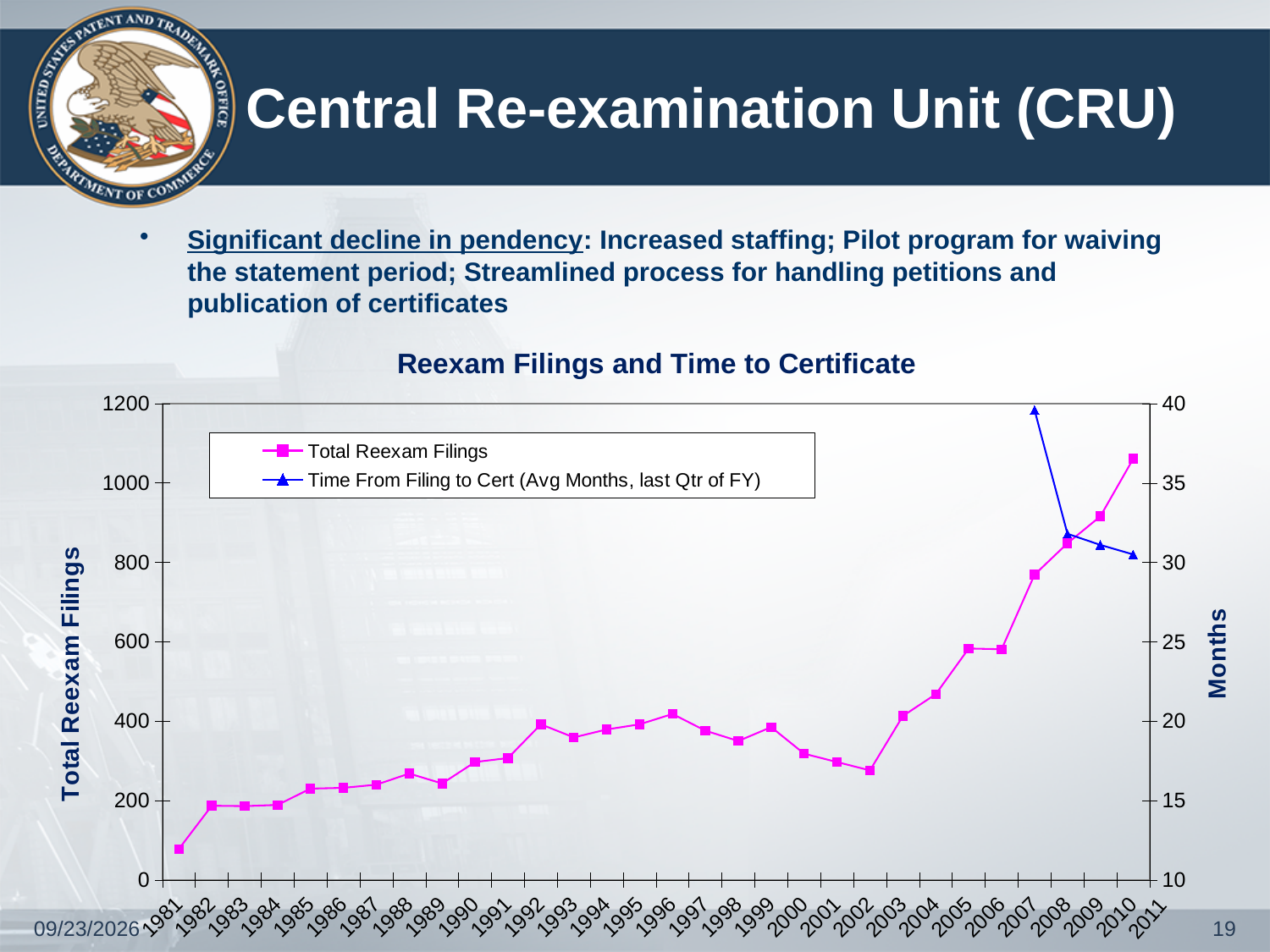
Is the Time From Filing to Cert value in 2007 greater or less than 35 months? greater What is the title of the chart? Reexam Filings and Time to Certificate What kind of chart is shown on the slide? Line chart In which year are Total Reexam Filings lowest? 1981 Is the Time From Filing to Cert value in 2010 greater or less than 35 months? less Is the value for Total Reexam Filings in 2010 greater or less than 1000? greater In which year are Total Reexam Filings highest? 2010 How many series does the chart legend list? 2 What is the label of the left vertical axis? Total Reexam Filings Which year has more Total Reexam Filings, 1996 or 2002? 1996 Does the Time From Filing to Cert series rise or fall from 2007 to 2010? Fall